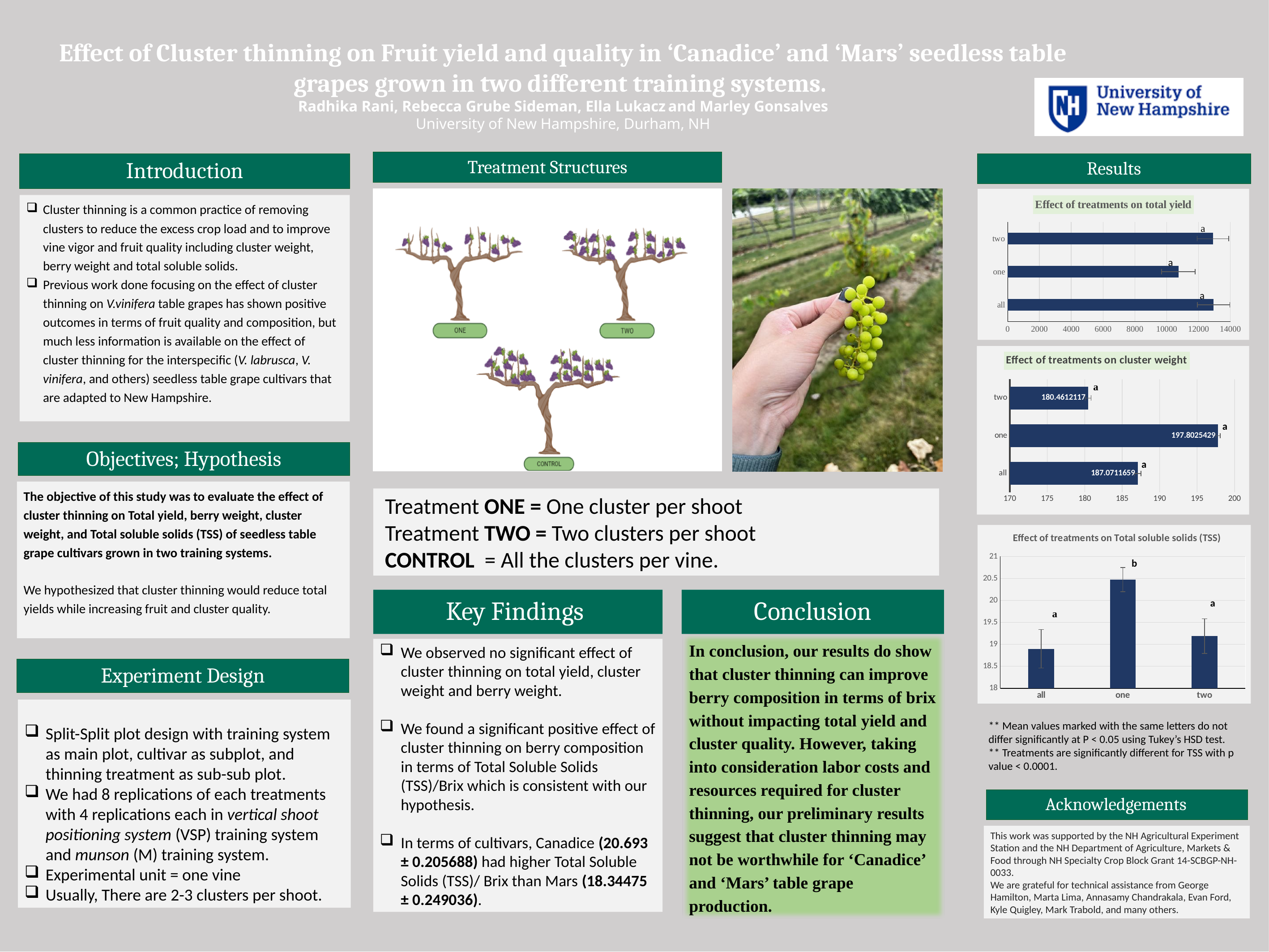
In the 'Effect of treatments on total yield' chart, is the value for 'one' greater or less than 12000? less In the 'Effect of treatments on cluster weight' chart, which treatment has the lowest cluster weight? two In the 'Effect of treatments on total yield' chart, which treatment has the lowest total yield? one What kind of chart is the 'Effect of treatments on Total soluble solids (TSS)' chart? bar chart In the 'Effect of treatments on Total soluble solids (TSS)' chart, which treatment has the highest TSS? one In the 'Effect of treatments on cluster weight' chart, what is the difference between the values for 'one' and 'two'? 17.3413312 In the 'Effect of treatments on Total soluble solids (TSS)' chart, is the value for 'one' greater or less than 20? greater In the 'Effect of treatments on total yield' chart, is the value for 'two' greater or less than 12000? greater In the 'Effect of treatments on cluster weight' chart, what is the value for 'all'? 187.0711659 In the 'Effect of treatments on cluster weight' chart, what is the value for treatment 'two'? 180.4612117 In the 'Effect of treatments on cluster weight' chart, which treatment has the highest cluster weight? one In the 'Effect of treatments on cluster weight' chart, what is the value for treatment 'one'? 197.8025429